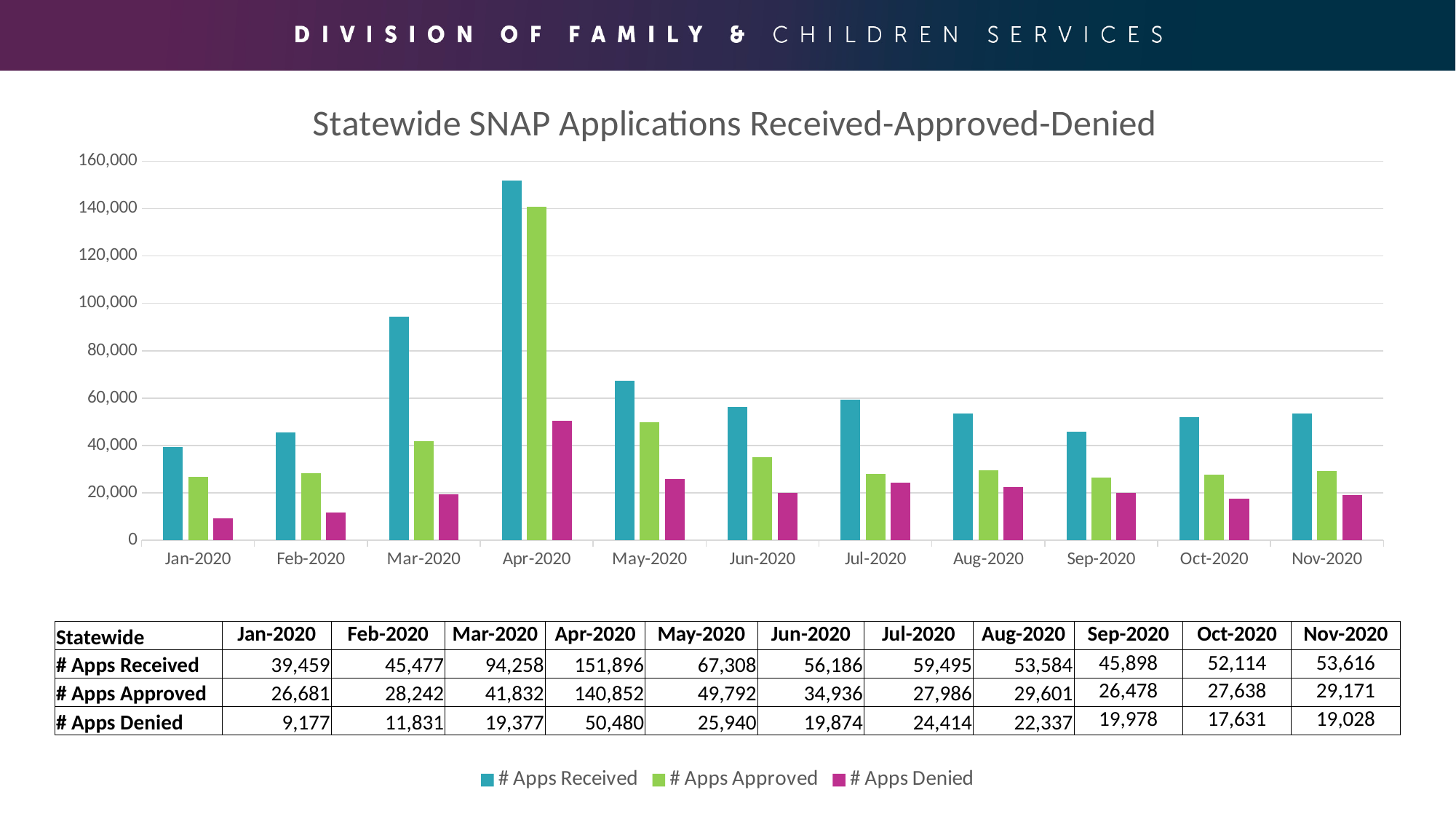
Which month has the lowest # Apps Denied? Jan-2020 What kind of chart is shown on the slide? bar chart Which month has more # Apps Received, Jul-2020 or Aug-2020? Jul-2020 Which month has the highest # Apps Received? Apr-2020 What is the value of # Apps Denied for Jan-2020? 9,177 What is the difference between # Apps Received and # Apps Approved in Apr-2020? 11,044 How many months are shown on the x axis of the chart? 11 Do the # Apps Received values rise or fall from Apr-2020 to Jun-2020? fall What is the value of # Apps Approved for Nov-2020? 29,171 How many series does the legend list? 3 Is the value for # Apps Received in Mar-2020 greater or less than 80,000? greater What is the value of # Apps Received for Apr-2020? 151,896